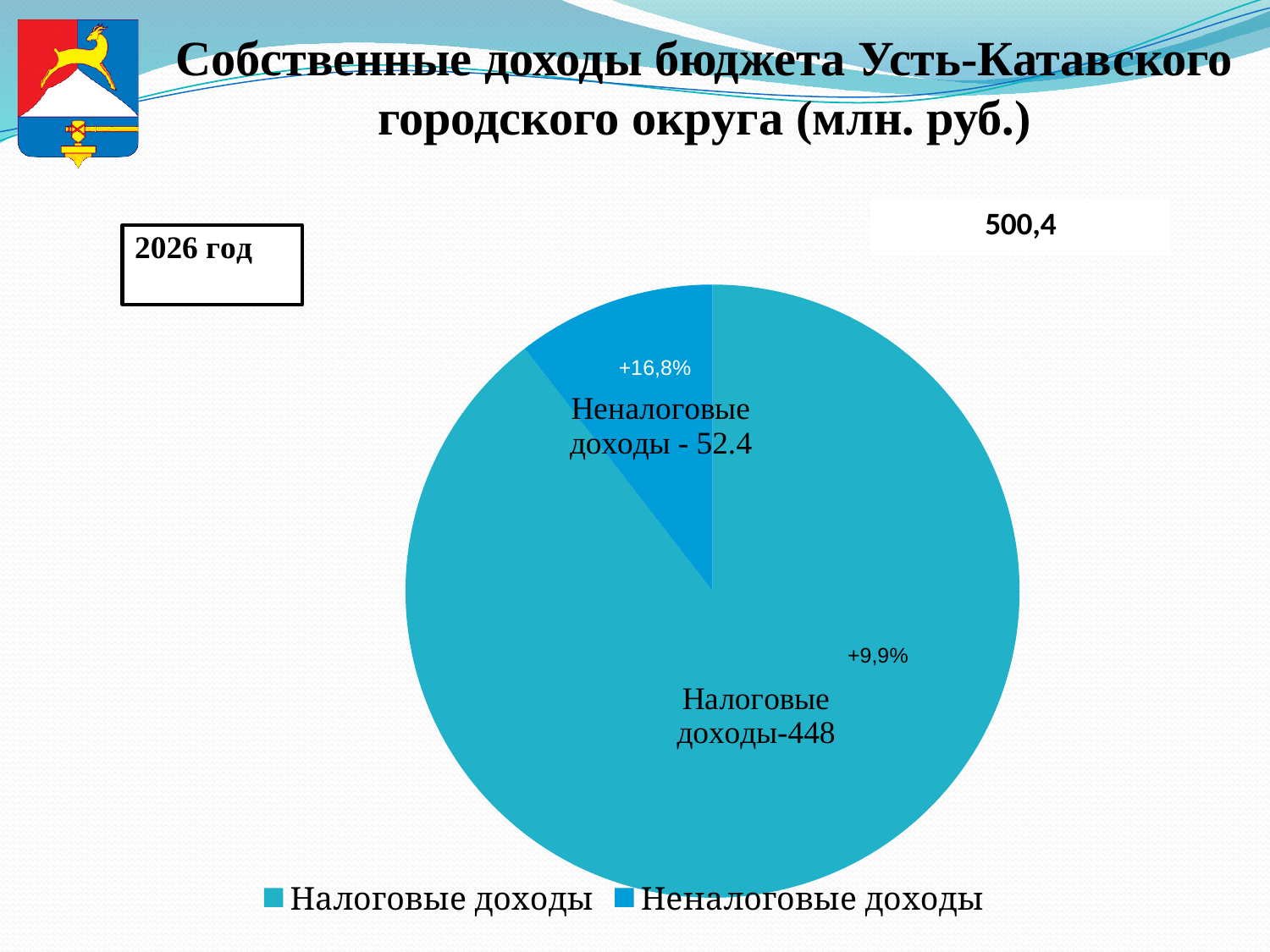
What is the difference between the values for Налоговые доходы and Неналоговые доходы? 395.6 What percentage change is shown next to the Неналоговые доходы slice? +16,8% Which is larger: Налоговые доходы or Неналоговые доходы? Налоговые доходы Which year is indicated in the box on the slide? 2026 год How many slices does the pie chart have? 2 What total value is shown above the pie chart? 500,4 What type of chart is shown on the slide? pie chart What is the value for Неналоговые доходы? 52.4 What is the value for Налоговые доходы? 448 Which category has the smallest slice of the pie? Неналоговые доходы How many entries does the legend list? 2 Which category has the largest slice of the pie? Налоговые доходы